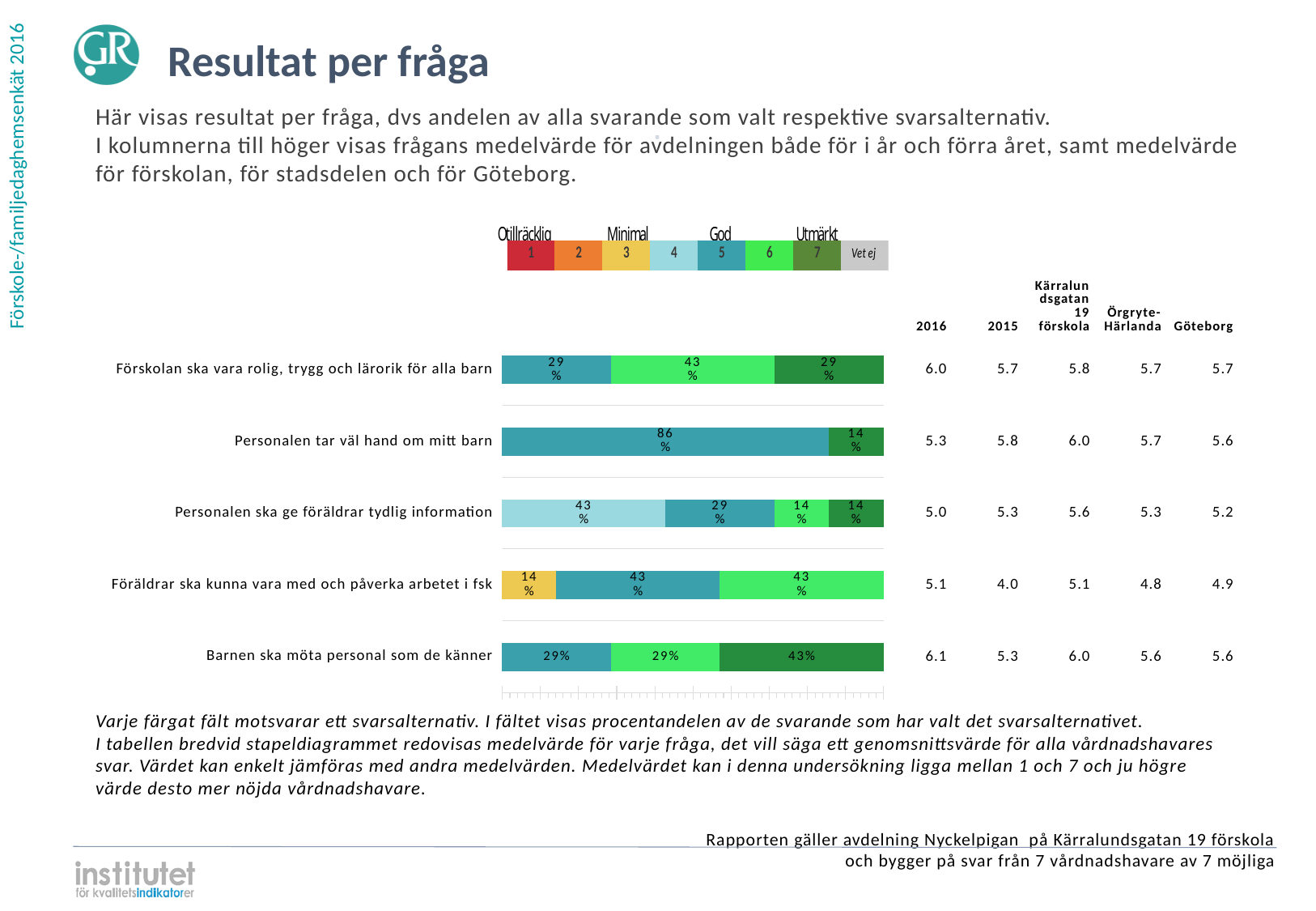
What percentage chose answer 3 (yellow) for 'Föräldrar ska kunna vara med och påverka arbetet i fsk'? 14% What is the difference between the 86% segment and the 14% segment in the bar for 'Personalen tar väl hand om mitt barn'? 72 percentage points Which is larger for 'Barnen ska möta personal som de känner': the share choosing 5 (teal) or the share choosing 7 (dark green)? 7 (dark green), 43% What percentage chose answer 7 (dark green) for 'Barnen ska möta personal som de känner'? 43% What percentage of respondents chose answer 6 (light green) for 'Förskolan ska vara rolig, trygg och lärorik för alla barn'? 43% What kind of chart is used to show the results per question? Stacked bar chart What is the largest segment in the bar for 'Personalen tar väl hand om mitt barn'? 86% How many coloured segments does the bar for 'Personalen ska ge föräldrar tydlig information' have? 4 How many questions (categories) are shown as bars in the chart? 5 How many answer alternatives does the colour legend above the chart list, including 'Vet ej'? 8 What percentage chose answer 4 (light blue) for 'Personalen ska ge föräldrar tydlig information'? 43% What is the 2016 mean value shown for 'Barnen ska möta personal som de känner'? 6.1